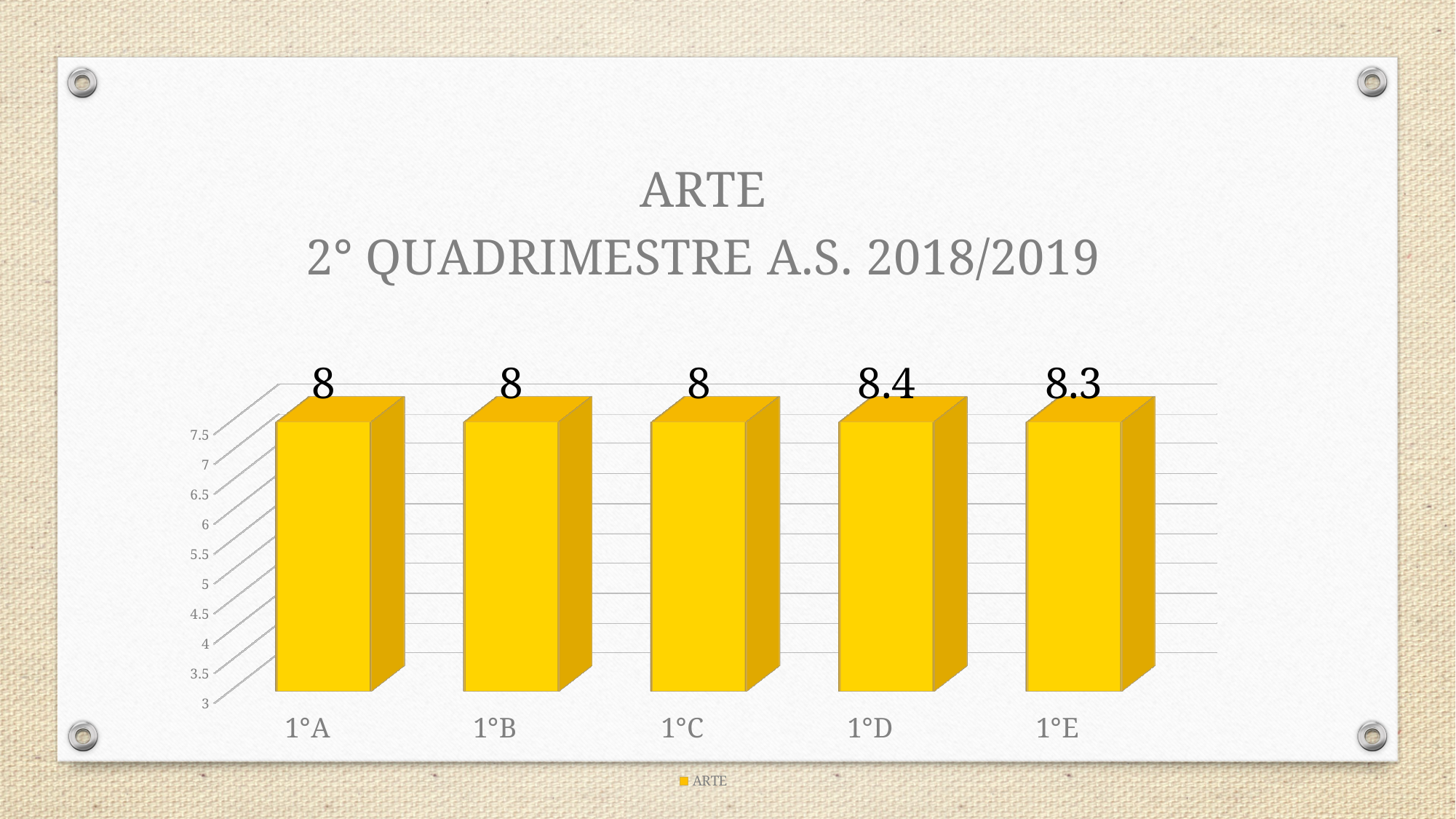
What is the name of the series in the legend? ARTE What kind of chart is shown? bar chart Which class has the highest value? 1°D Which is larger, the value for 1°E or the value for 1°C? 1°E Is the value for 1°B greater or less than 7.5? greater What is the value for 1°D? 8.4 What is the value for 1°E? 8.3 How many classes are shown on the x axis? 5 What is the value for 1°A? 8 What is the difference between the values for 1°D and 1°B? 0.4 What is the difference between the values for 1°D and 1°E? 0.1 How many series does the legend list? 1